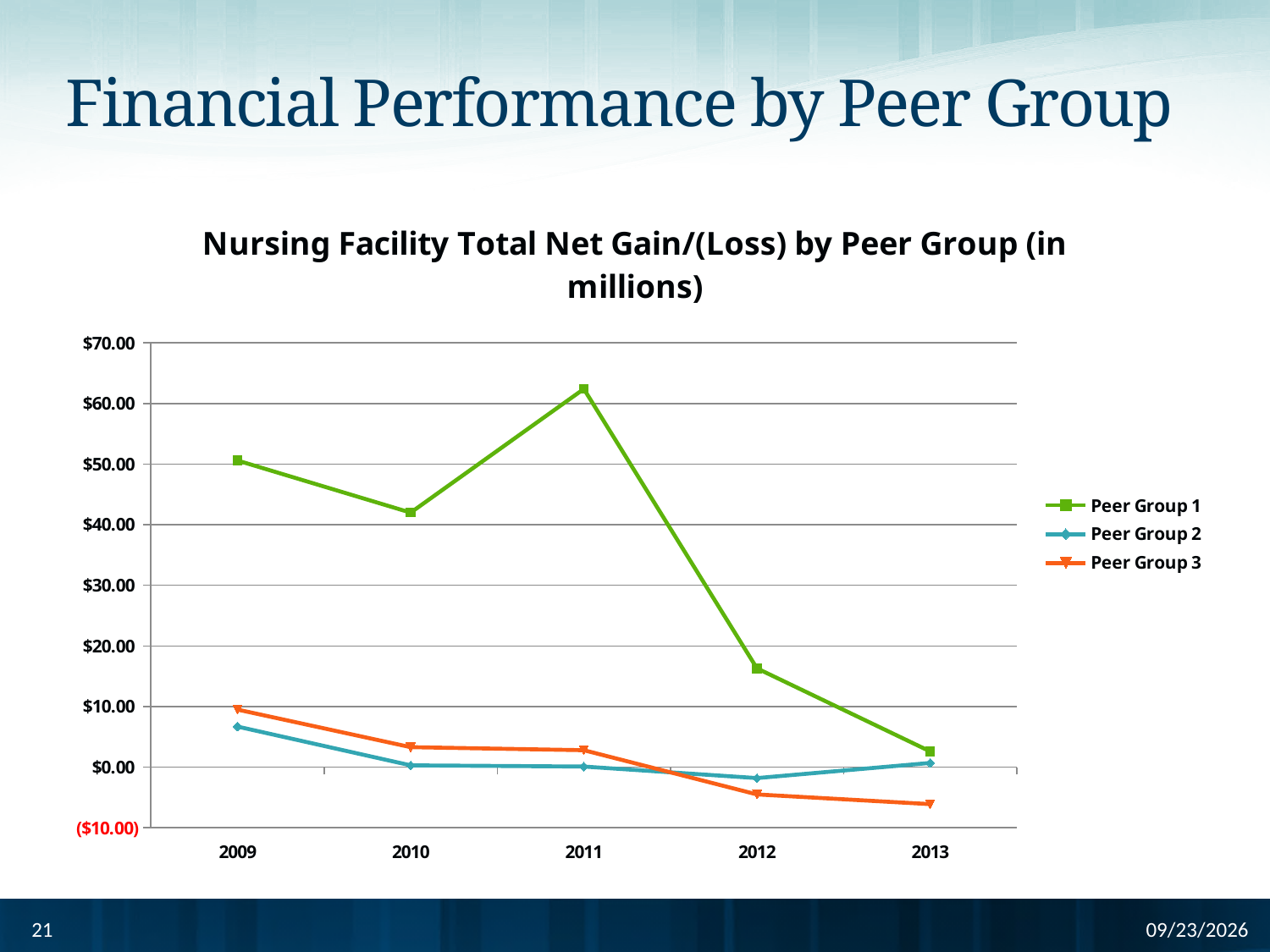
Is the value for Peer Group 3 in 2013 greater or less than $0.00? less Which is larger in 2009, the value for Peer Group 2 or Peer Group 3? Peer Group 3 What is the title of the chart? Nursing Facility Total Net Gain/(Loss) by Peer Group (in millions) Which is larger in 2013, the value for Peer Group 2 or Peer Group 3? Peer Group 2 Is the value for Peer Group 1 in 2012 greater or less than $20.00? less What kind of chart is shown on the slide? Line chart How many series does the legend list? 3 In which year does Peer Group 1 have its lowest value? 2013 In which year does Peer Group 1 reach its highest value? 2011 Does the Peer Group 3 line rise or fall overall from 2009 to 2013? Fall Is the value for Peer Group 1 in 2011 greater or less than $60.00? greater How many years are plotted along the x axis? 5